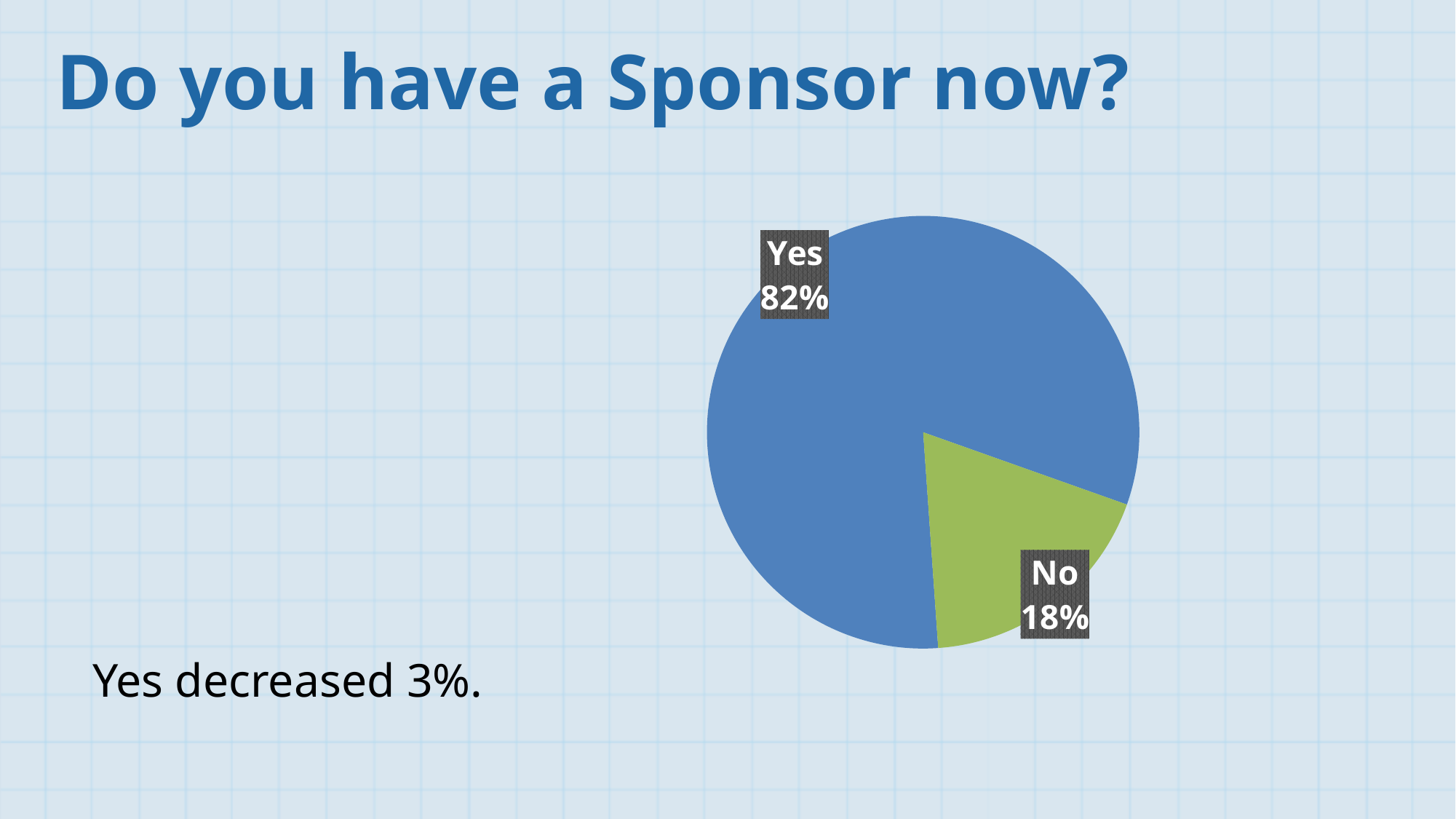
What is the title of the slide containing the chart? Do you have a Sponsor now? Which response has the smallest share of the pie? No What percentage of respondents answered Yes to having a sponsor now? 82% What colour is the Yes slice of the pie chart? Blue What share of the pie does the No slice represent? 18% Which slice is larger, Yes or No? Yes What kind of chart is shown on the slide? Pie chart How many slices does the pie chart have? 2 Is the Yes slice greater or less than 50% of the pie? greater What percentage of respondents answered No to having a sponsor now? 18% What is the difference in percentage points between the Yes and No slices? 64 Which response has the largest share of the pie? Yes